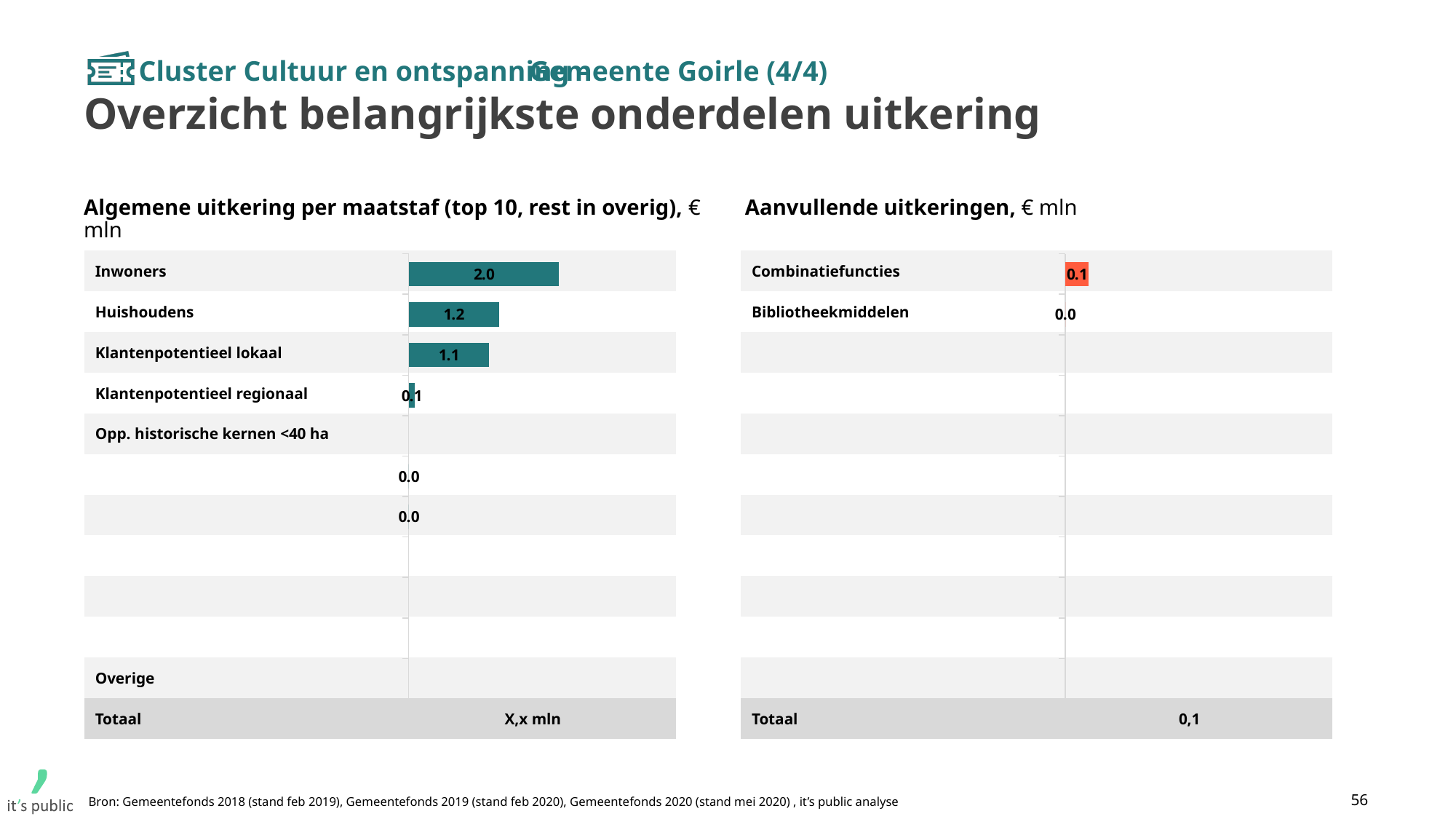
In the chart 'Algemene uitkering per maatstaf', what is the difference between the values for Inwoners and Huishoudens? 0.8 In the chart 'Aanvullende uitkeringen', what is the value for Combinatiefuncties? 0.1 In the chart 'Algemene uitkering per maatstaf', which category has the highest value? Inwoners In the chart 'Algemene uitkering per maatstaf', what is the value for Huishoudens? 1.2 In the chart 'Algemene uitkering per maatstaf', what is the value for Inwoners? 2.0 In the chart 'Aanvullende uitkeringen', what is the Totaal shown? 0,1 What type of chart is used for 'Aanvullende uitkeringen'? Bar chart What unit is stated in the title of the chart 'Aanvullende uitkeringen'? € mln In the chart 'Algemene uitkering per maatstaf', what is the value for Klantenpotentieel regionaal? 0.1 In the chart 'Algemene uitkering per maatstaf', which is larger: Huishoudens or Klantenpotentieel lokaal? Huishoudens In the chart 'Aanvullende uitkeringen', what is the value for Bibliotheekmiddelen? 0.0 In the chart 'Algemene uitkering per maatstaf', what is the value for Klantenpotentieel lokaal? 1.1